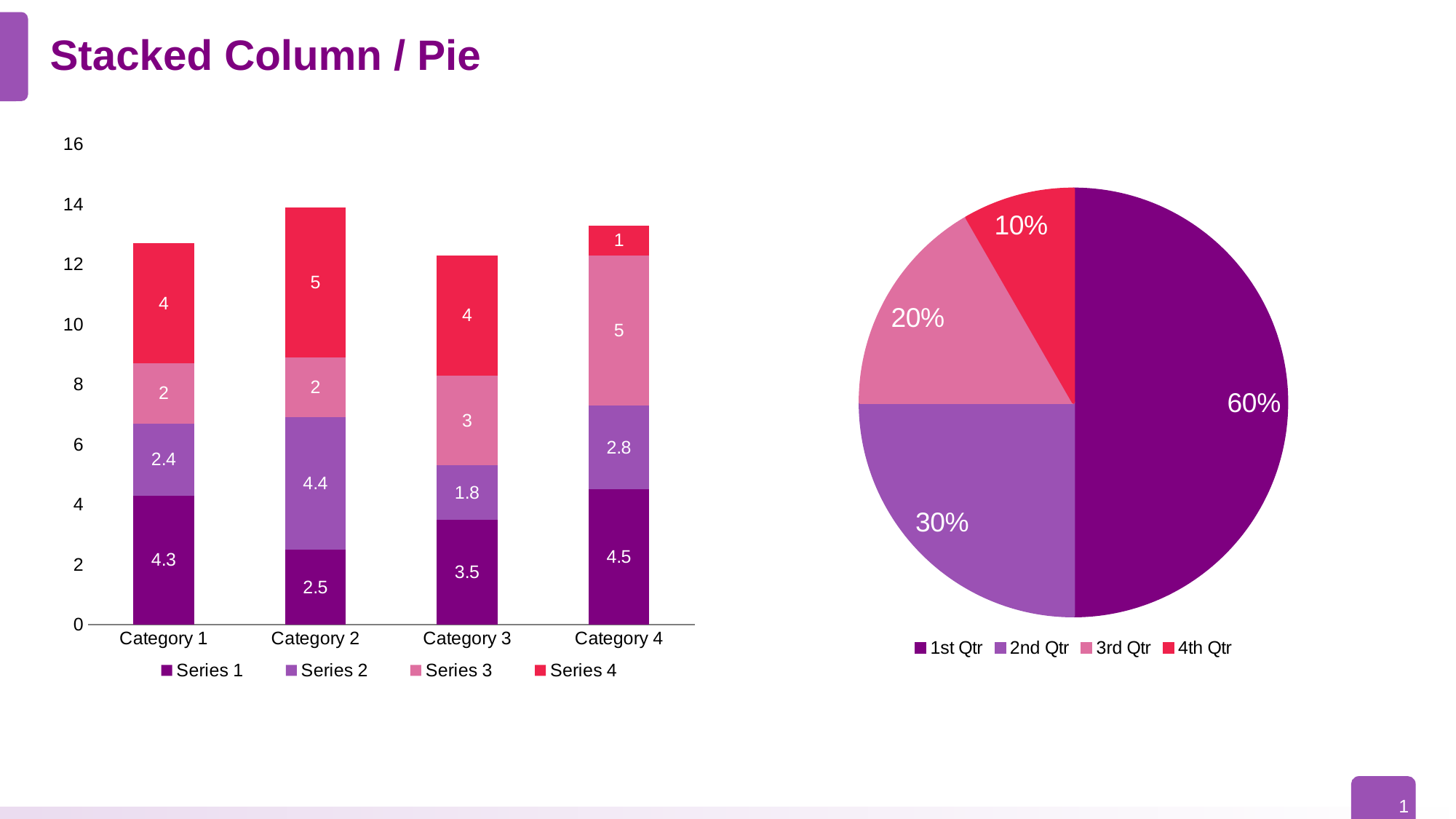
How many series does the legend of the stacked bar chart on the left list? 4 In the stacked bar chart on the left, what is the value of Series 1 for Category 4? 4.5 In the stacked bar chart on the left, which category has the highest Series 1 value? Category 4 What kind of chart is shown on the right side of the slide? Pie chart In the stacked bar chart on the left, what is the difference between the Series 1 values for Category 1 and Category 2? 1.8 In the pie chart on the right, which quarter has the smallest slice? 4th Qtr In the stacked bar chart on the left, is the Series 3 value larger for Category 3 or Category 4? Category 4 In the stacked bar chart on the left, which category has the lowest Series 2 value? Category 3 In the stacked bar chart on the left, what is the total of the stacked bar for Category 2? 13.9 In the pie chart on the right, what share is labelled for the 1st Qtr slice? 60% In the stacked bar chart on the left, what is the value of Series 4 for Category 4? 1 In the stacked bar chart on the left, what is the value of Series 2 for Category 2? 4.4